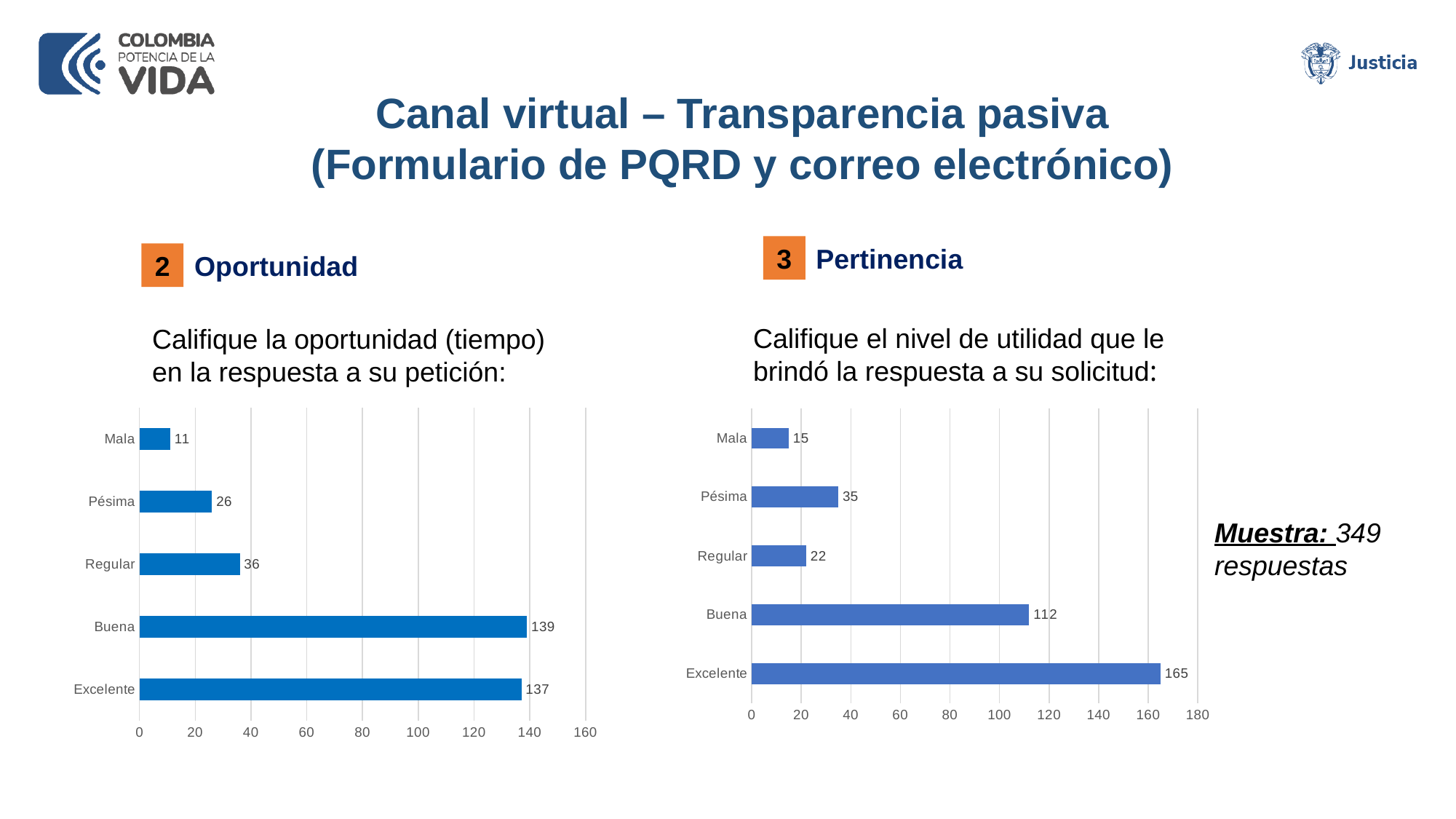
In the Pertinencia chart on the right, what is the difference between Excelente and Buena? 53 In the Pertinencia chart on the right, which category has the highest value? Excelente In the Oportunidad chart on the left, what is the difference between Regular and Pésima? 10 In the Oportunidad chart on the left, what is the value for Regular? 36 In the Pertinencia chart on the right, what is the value for Excelente? 165 In the Pertinencia chart on the right, what is the value for Pésima? 35 In the Oportunidad chart on the left, which category has the highest value? Buena In the Pertinencia chart on the right, which is larger, Pésima or Regular? Pésima How many categories does the Oportunidad chart on the left show? 5 In the Oportunidad chart on the left, which category has the lowest value? Mala In the Oportunidad chart on the left, what is the value for Mala? 11 What type of chart is the Pertinencia chart on the right? Bar chart